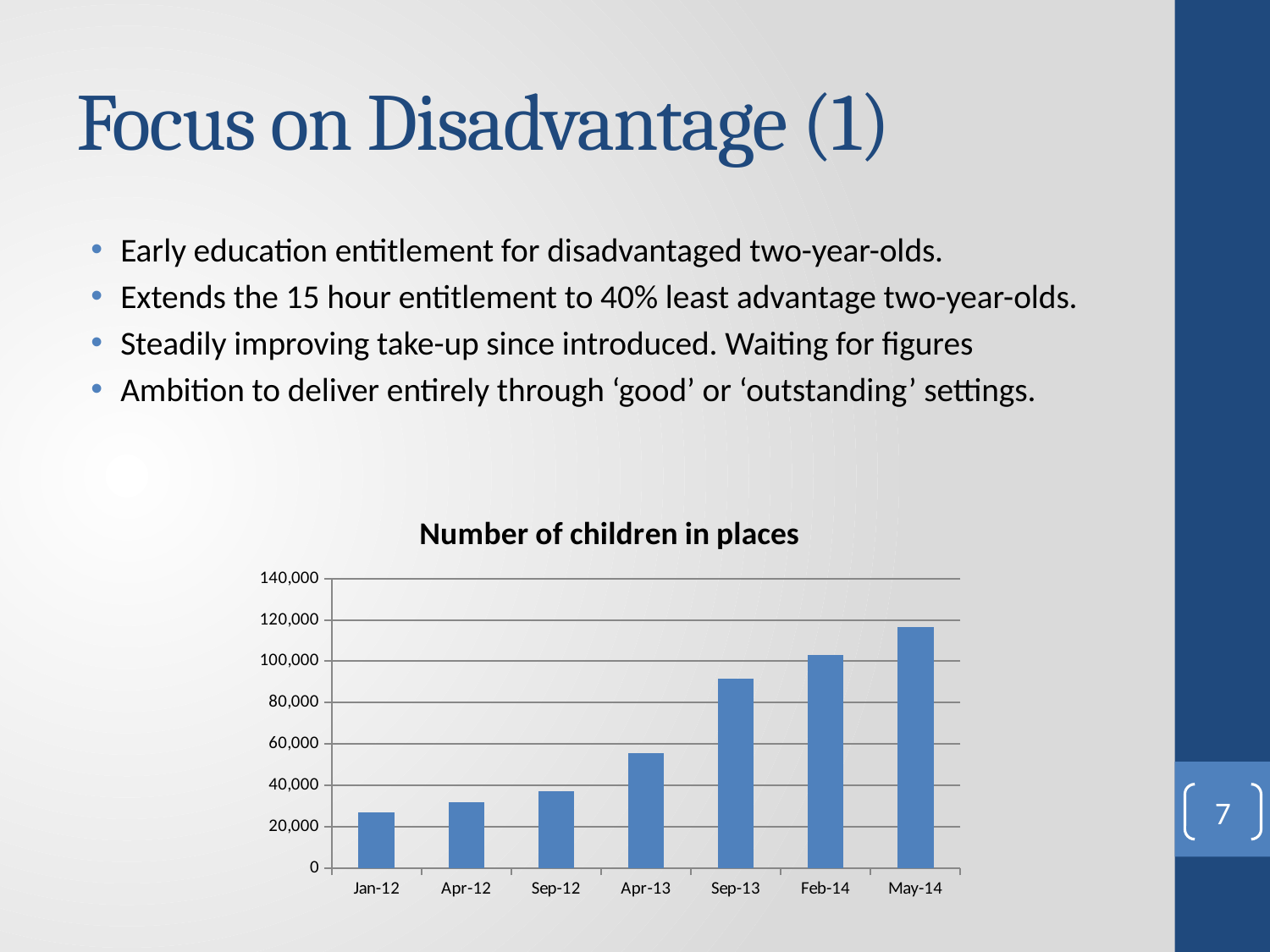
Is the value for May-14 greater or less than 100,000? greater What type of chart is shown on the slide? bar chart Is the value for Jan-12 greater or less than 20,000? greater Which category has the lowest number of children in places? Jan-12 Do the values rise or fall from Jan-12 to May-14? rise Which category has the highest number of children in places? May-14 How many categories (time points) are shown on the x axis of the chart? 7 What is the title of the chart? Number of children in places Is the value for Sep-13 greater or less than 80,000? greater Which is larger, the value for Apr-13 or the value for Sep-13? Sep-13